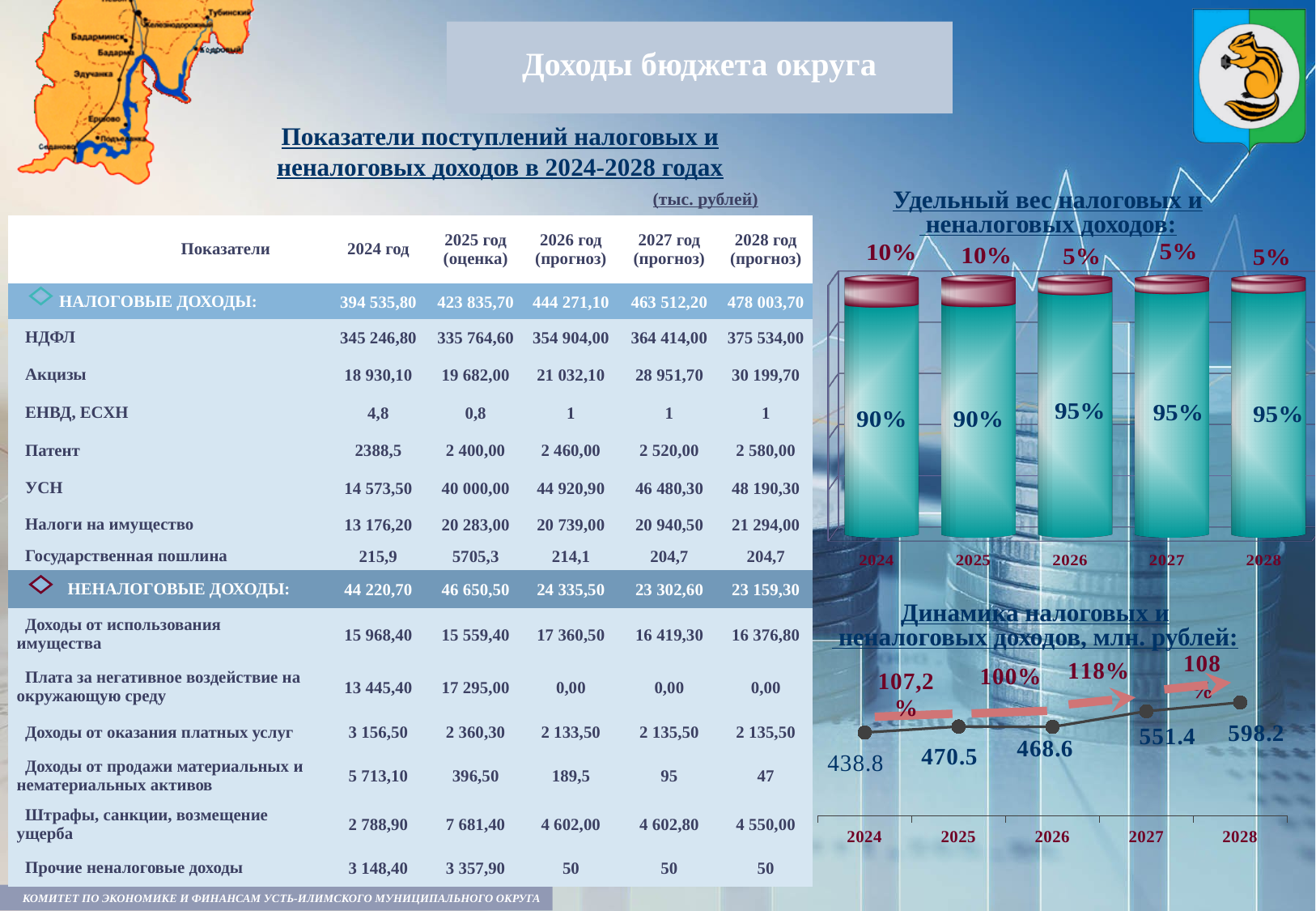
In the chart 'Динамика налоговых и неналоговых доходов, млн. рублей', which year has the lowest value? 2024 In the chart 'Динамика налоговых и неналоговых доходов, млн. рублей', what is the value for 2024? 438.8 In the chart 'Динамика налоговых и неналоговых доходов, млн. рублей', what is the value for 2028? 598.2 In the chart 'Удельный вес налоговых и неналоговых доходов', what is the share of the upper segment in 2027? 5% In the chart 'Удельный вес налоговых и неналоговых доходов', how many years are shown on the x axis? 5 In the chart 'Динамика налоговых и неналоговых доходов, млн. рублей', how many data points are plotted? 5 In the chart 'Удельный вес налоговых и неналоговых доходов', is the lower segment for 2026 larger or smaller than the lower segment for 2025? larger In the chart 'Динамика налоговых и неналоговых доходов, млн. рублей', which year has the highest value? 2028 What kind of chart is 'Динамика налоговых и неналоговых доходов, млн. рублей'? line chart In the chart 'Удельный вес налоговых и неналоговых доходов', what is the share of tax revenues (lower segment) in 2024? 90% In the chart 'Динамика налоговых и неналоговых доходов, млн. рублей', what is the difference between the 2028 and 2024 values? 159.4 In the chart 'Динамика налоговых и неналоговых доходов, млн. рублей', what is the value for 2027? 551.4